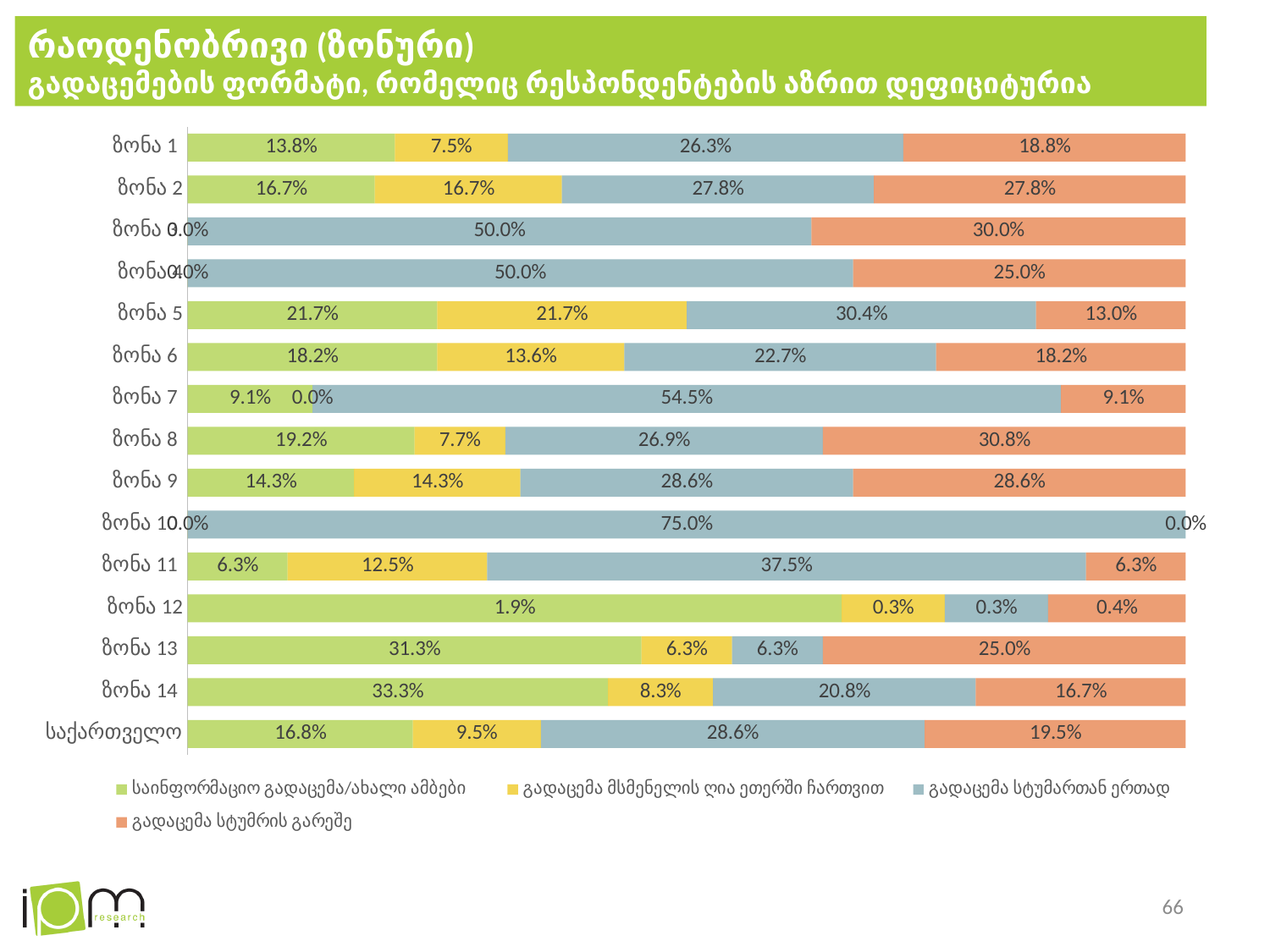
What kind of chart is shown on the slide? Stacked bar chart How many series does the legend list? 4 Which is larger: the გადაცემა სტუმართან ერთად value for ზონა 7 or for ზონა 11? ზონა 7 What is the value of საინფორმაციო გადაცემა/ახალი ამბები for ზონა 14? 33.3% What is the value of გადაცემა სტუმართან ერთად for ზონა 10? 75.0% Which category has the highest value for საინფორმაციო გადაცემა/ახალი ამბები? ზონა 14 What is the value of გადაცემა მსმენელის ღია ეთერში ჩართვით for საქართველო? 9.5% What is the difference between the გადაცემა სტუმრის გარეშე values for ზონა 8 and ზონა 5? 17.8% Which series is shown in orange in the legend? გადაცემა სტუმრის გარეშე What is the value of გადაცემა სტუმრის გარეშე for ზონა 8? 30.8% How many categories are plotted on the y axis? 15 Which category has the highest value for გადაცემა სტუმართან ერთად? ზონა 10